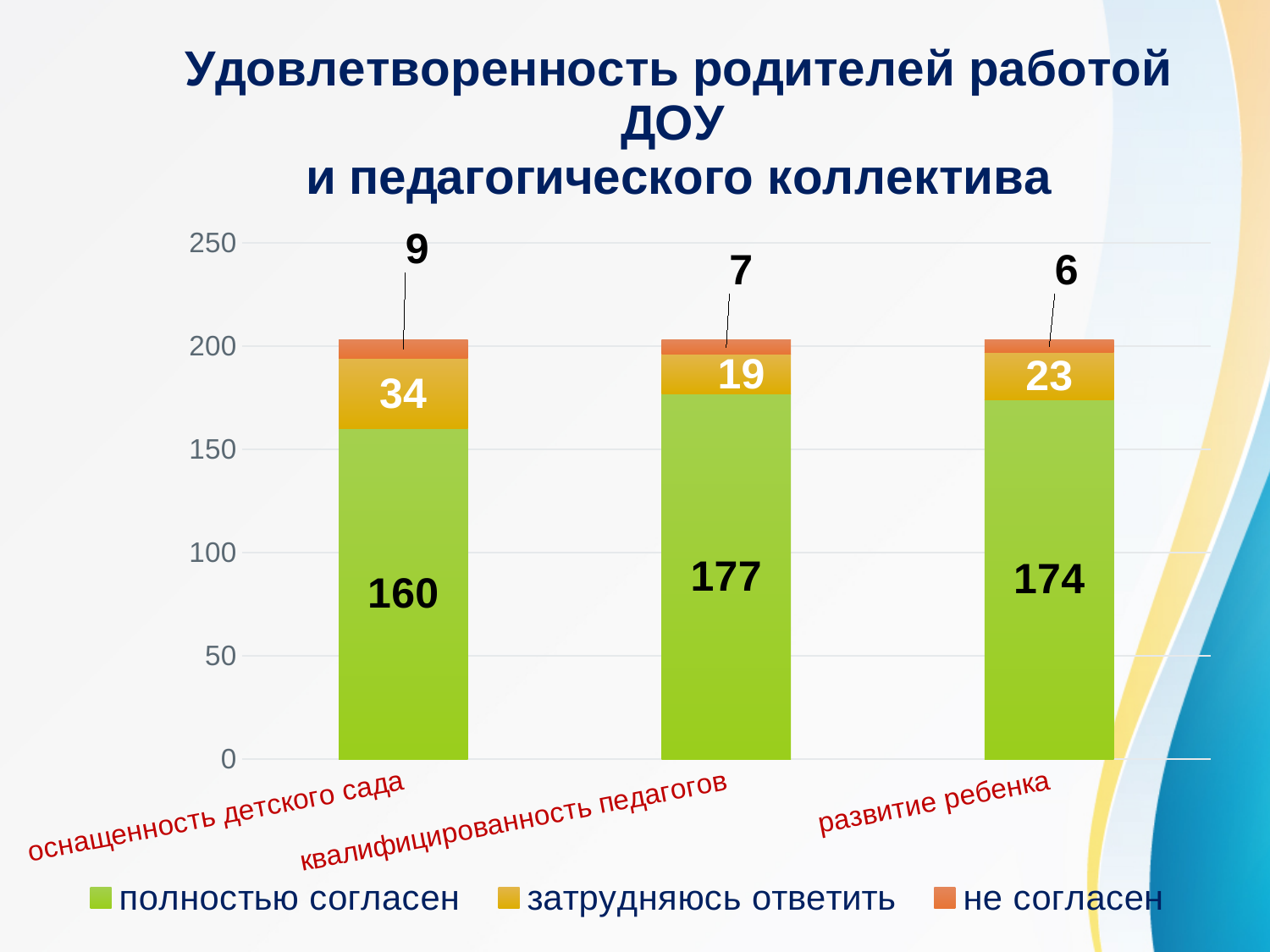
What is the total of the stacked bar for 'квалифицированность педагогов'? 203 How many categories are shown on the x axis? 3 What type of chart is shown on the slide? stacked bar chart What is the value of 'затрудняюсь ответить' for 'квалифицированность педагогов'? 19 Which series is shown in orange in the legend? не согласен Which category has the highest value for 'полностью согласен'? квалифицированность педагогов What is the value of 'не согласен' for 'развитие ребенка'? 6 Which category has the lowest value for 'не согласен'? развитие ребенка Which is larger: the 'полностью согласен' value for 'развитие ребенка' or for 'оснащенность детского сада'? развитие ребенка How many series does the legend list? 3 What is the difference between the 'затрудняюсь ответить' values for 'оснащенность детского сада' and 'развитие ребенка'? 11 What is the value of 'полностью согласен' for 'оснащенность детского сада'? 160